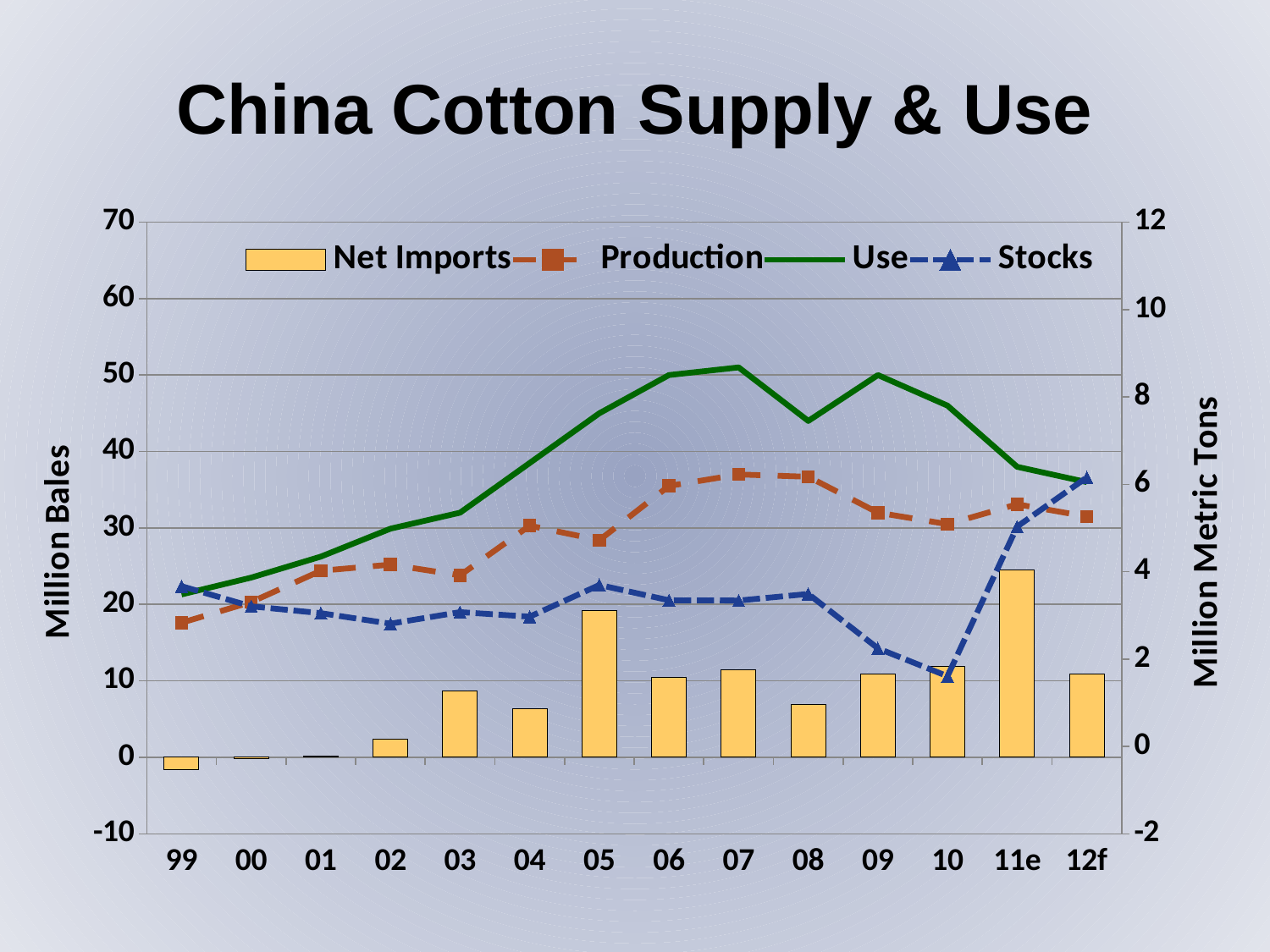
What kind of chart is shown on the slide? A combination bar and line chart In which year are Net Imports lowest? 99 In which year are Stocks highest? 12f How many series does the legend list? 4 Is the Net Imports value for 11e greater or less than 20 million bales? greater In which year are Net Imports highest? 11e Does Use rise or fall from 99 to 07? Rise Which is larger in 05, Use or Production? Use Is the Use value for 08 greater or less than 50 million bales? less How many years are shown along the x axis? 14 What is the title of the chart? China Cotton Supply & Use In which year are Stocks lowest? 10